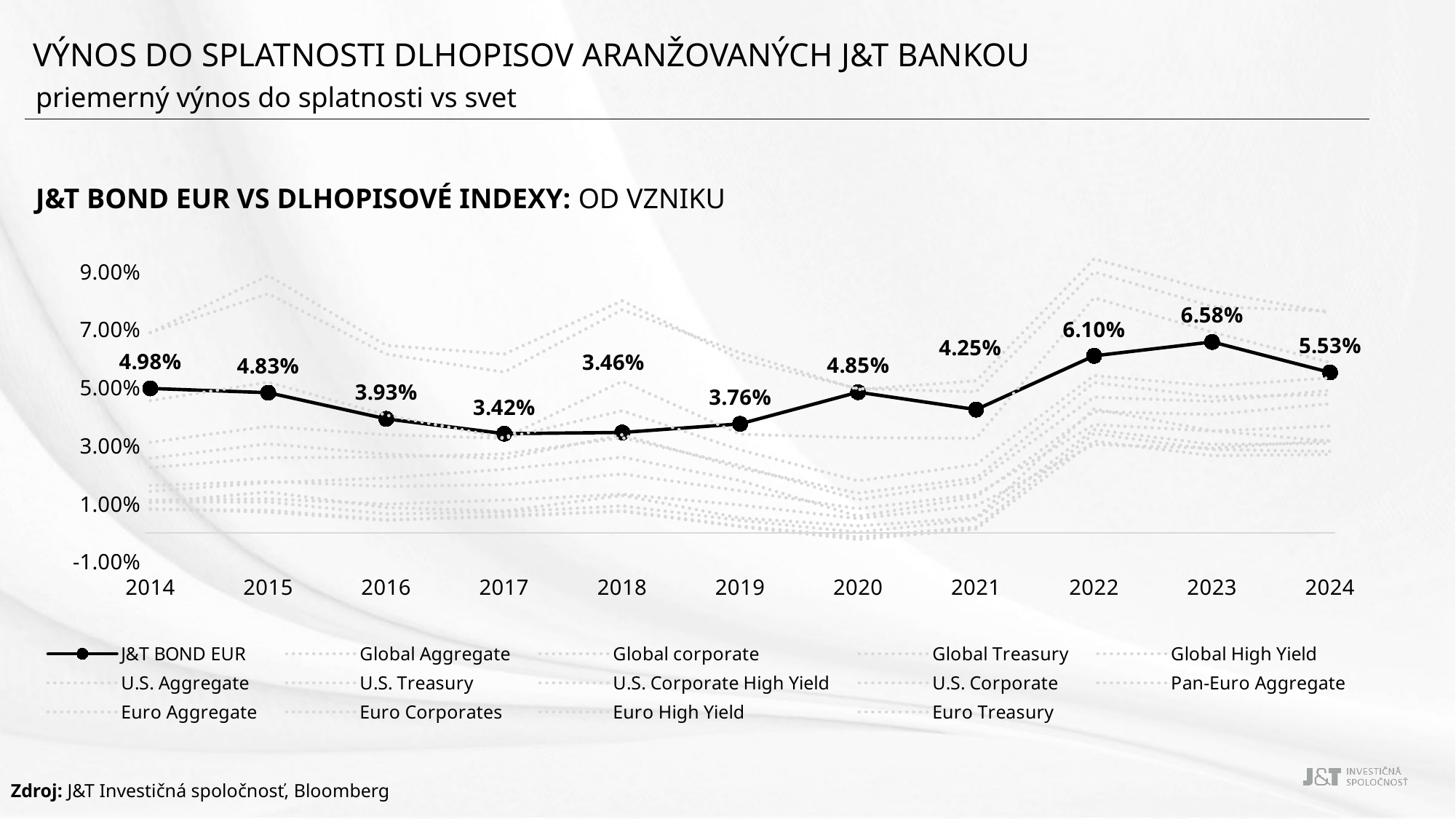
What is the difference between the J&T BOND EUR values in 2023 and 2024? 1.05% What is the difference between the J&T BOND EUR values in 2023 and 2022? 0.48% Is the J&T BOND EUR value for 2022 greater or less than 5.00%? greater In which year does the J&T BOND EUR series reach its highest value? 2023 What kind of chart is shown on the slide? line chart What is the value of J&T BOND EUR in 2023? 6.58% Which year has the higher J&T BOND EUR value, 2016 or 2019? 2016 How many years are shown on the x axis of the chart? 11 What is the value of J&T BOND EUR in 2024? 5.53% What is the value of J&T BOND EUR in 2017? 3.42% How many series does the legend list? 14 In which year does the J&T BOND EUR series reach its lowest value? 2017